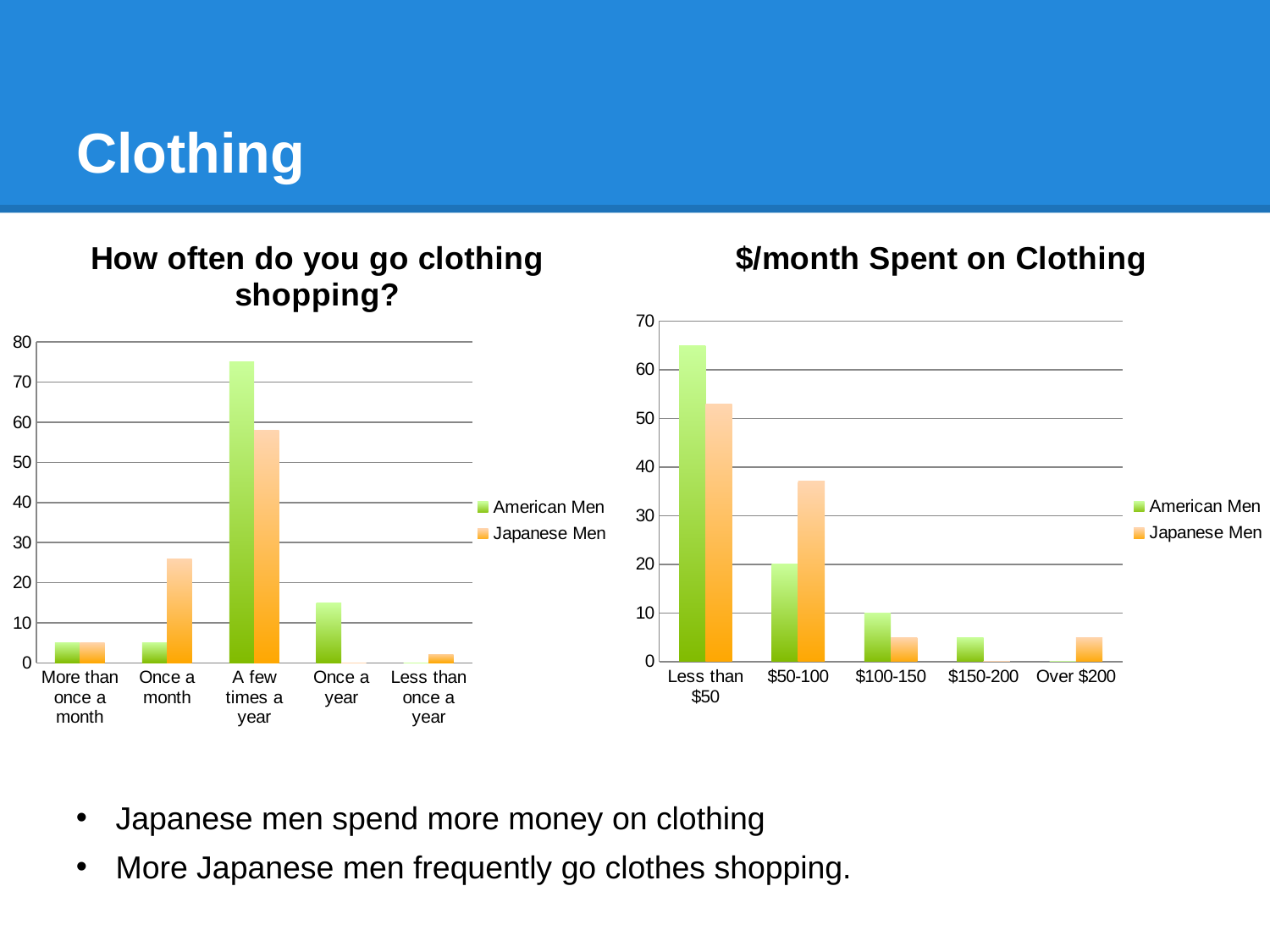
In the 'How often do you go clothing shopping?' chart, which series has the larger value for 'Once a month'? Japanese Men How many categories are shown on the x axis of the '$/month Spent on Clothing' chart? 5 How many categories are shown on the x axis of the 'How often do you go clothing shopping?' chart? 5 In the 'How often do you go clothing shopping?' chart, which category has the highest value for American Men? A few times a year What are the two legend entries in the 'How often do you go clothing shopping?' chart? American Men and Japanese Men In the '$/month Spent on Clothing' chart, is the value for Japanese Men at '$50-100' greater or less than 40? less In the '$/month Spent on Clothing' chart, which series has the larger value for '$50-100'? Japanese Men How many series does the legend of the '$/month Spent on Clothing' chart list? 2 What kind of chart is the 'How often do you go clothing shopping?' chart? bar chart In the '$/month Spent on Clothing' chart, which category has the highest value for Japanese Men? Less than $50 In the '$/month Spent on Clothing' chart, is the value for American Men at 'Less than $50' greater or less than 60? greater In the 'How often do you go clothing shopping?' chart, is the value for American Men at 'A few times a year' greater or less than 70? greater